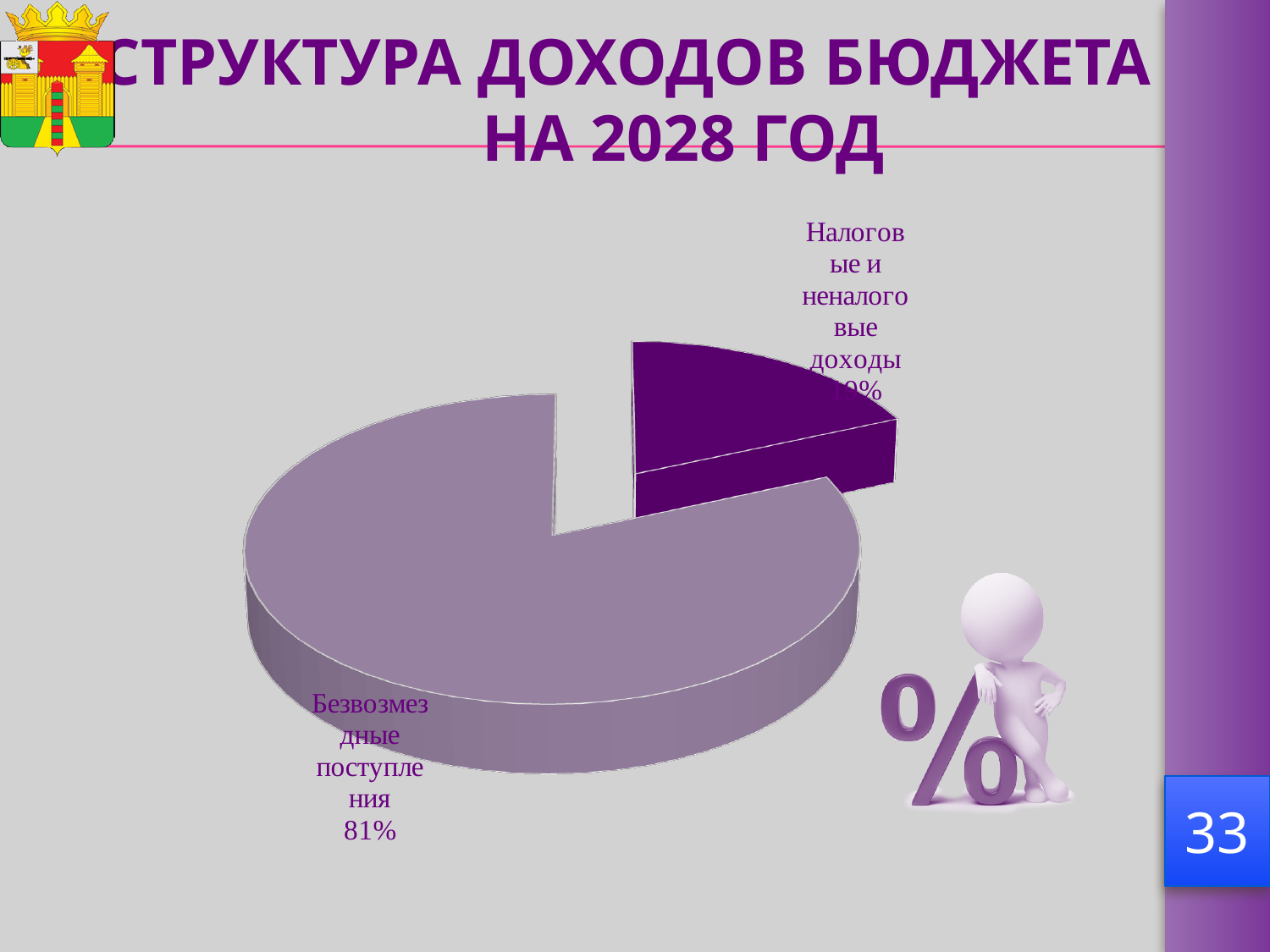
What share of the pie does "Безвозмездные поступления" account for? 81% What is the title of the slide containing the pie chart? СТРУКТУРА ДОХОДОВ БЮДЖЕТА НА 2028 ГОД Which category has the largest slice of the pie? Безвозмездные поступления Which slice of the pie is drawn in dark purple? Налоговые и неналоговые доходы What kind of chart is shown on the slide? pie chart Which category has the smallest slice of the pie? Налоговые и неналоговые доходы Which is larger: the slice for "Безвозмездные поступления" or the slice for "Налоговые и неналоговые доходы"? Безвозмездные поступления Is the share for "Налоговые и неналоговые доходы" greater or less than 50%? less Is the share for "Безвозмездные поступления" greater or less than 50%? greater How many slices does the pie chart have? 2